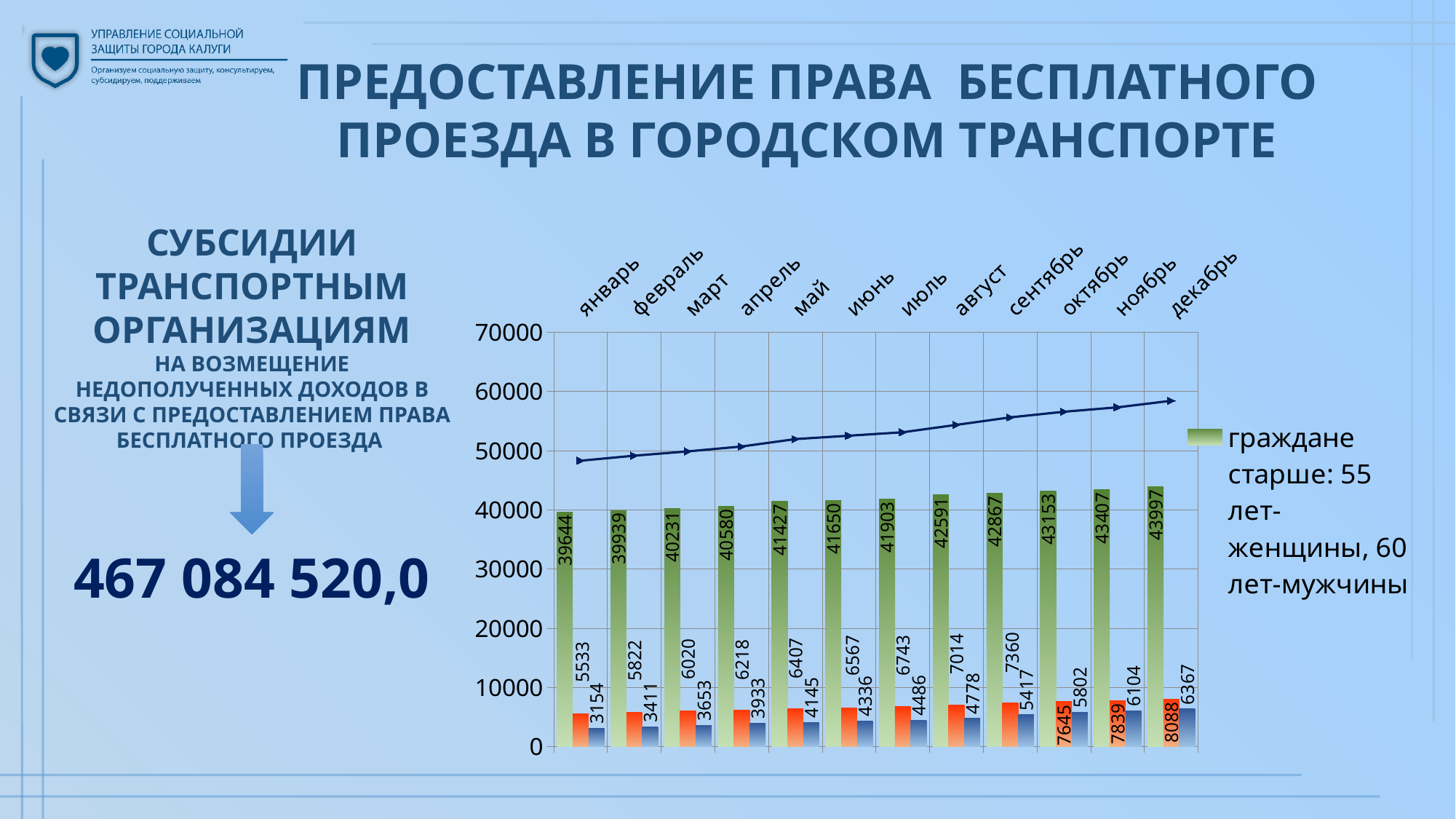
What is the value of the blue bar for сентябрь? 5417 In which month is the value for граждане старше: 55 лет-женщины, 60 лет-мужчины the lowest? январь Is the value of the line series for январь greater or less than 50000? less In which month is the value for граждане старше: 55 лет-женщины, 60 лет-мужчины the highest? декабрь What is the difference between the декабрь and январь values for граждане старше: 55 лет-женщины, 60 лет-мужчины? 4353 Do the values for граждане старше: 55 лет-женщины, 60 лет-мужчины rise or fall from январь to декабрь? rise In декабрь, which is larger: the orange bar or the blue bar? the orange bar What is the value for граждане старше: 55 лет-женщины, 60 лет-мужчины in январь? 39644 What is the value of the orange bar for июнь? 6567 What is the value for граждане старше: 55 лет-женщины, 60 лет-мужчины in декабрь? 43997 What is the highest tick value shown on the y axis of the chart? 70000 How many months are shown on the x axis of the chart? 12